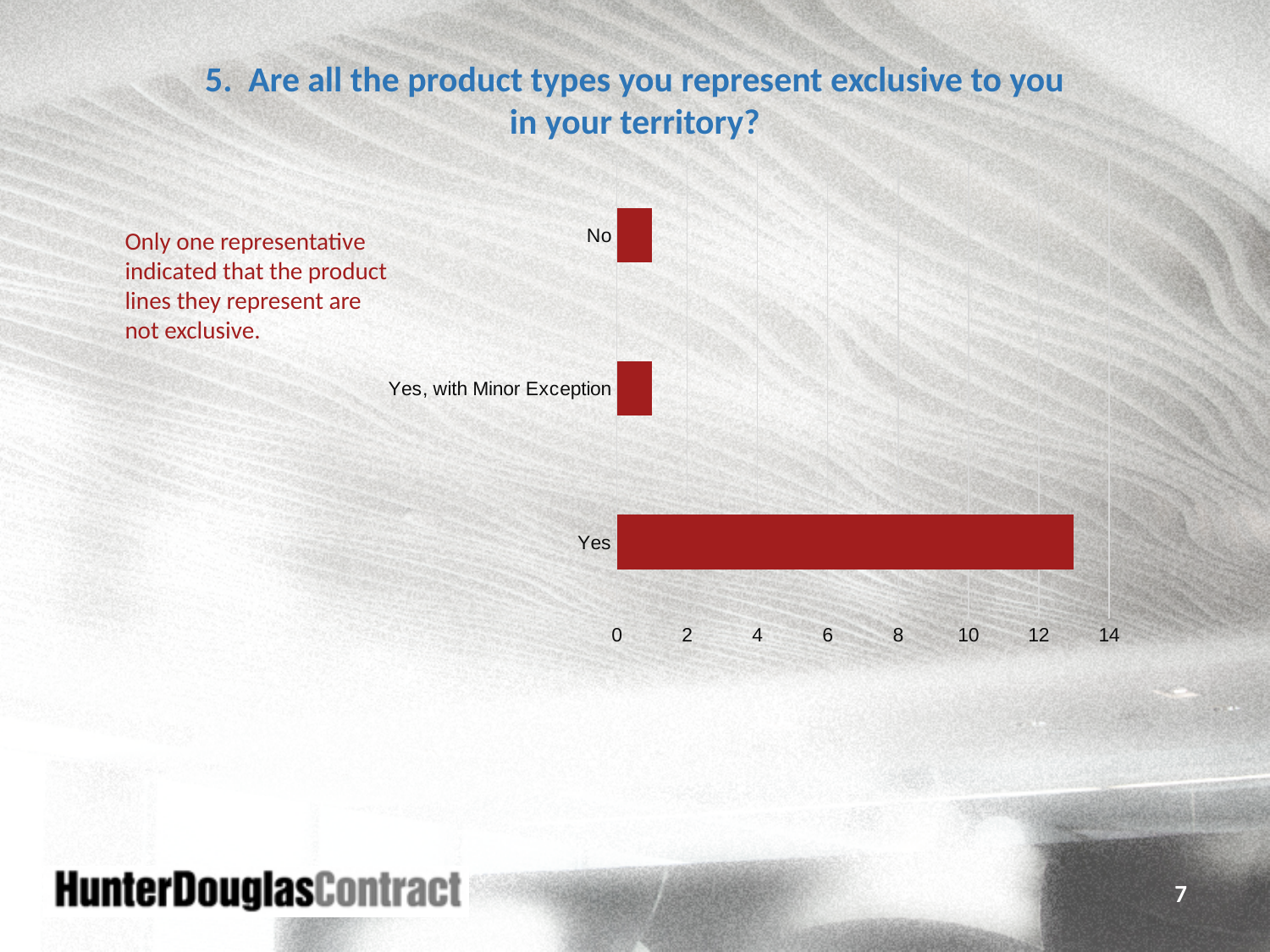
Is the value for No greater or less than 2? less Which is larger, the value for Yes or the value for Yes, with Minor Exception? Yes Is the value for Yes greater or less than 12? greater Which is larger, the value for Yes or the value for No? Yes How many categories are shown in the chart? 3 What colour are the bars in the chart? red What kind of chart is shown on the slide? bar chart Is the value for Yes, with Minor Exception greater or less than 2? less What is the highest value shown on the chart's horizontal axis? 14 Which category has the highest value in the chart? Yes